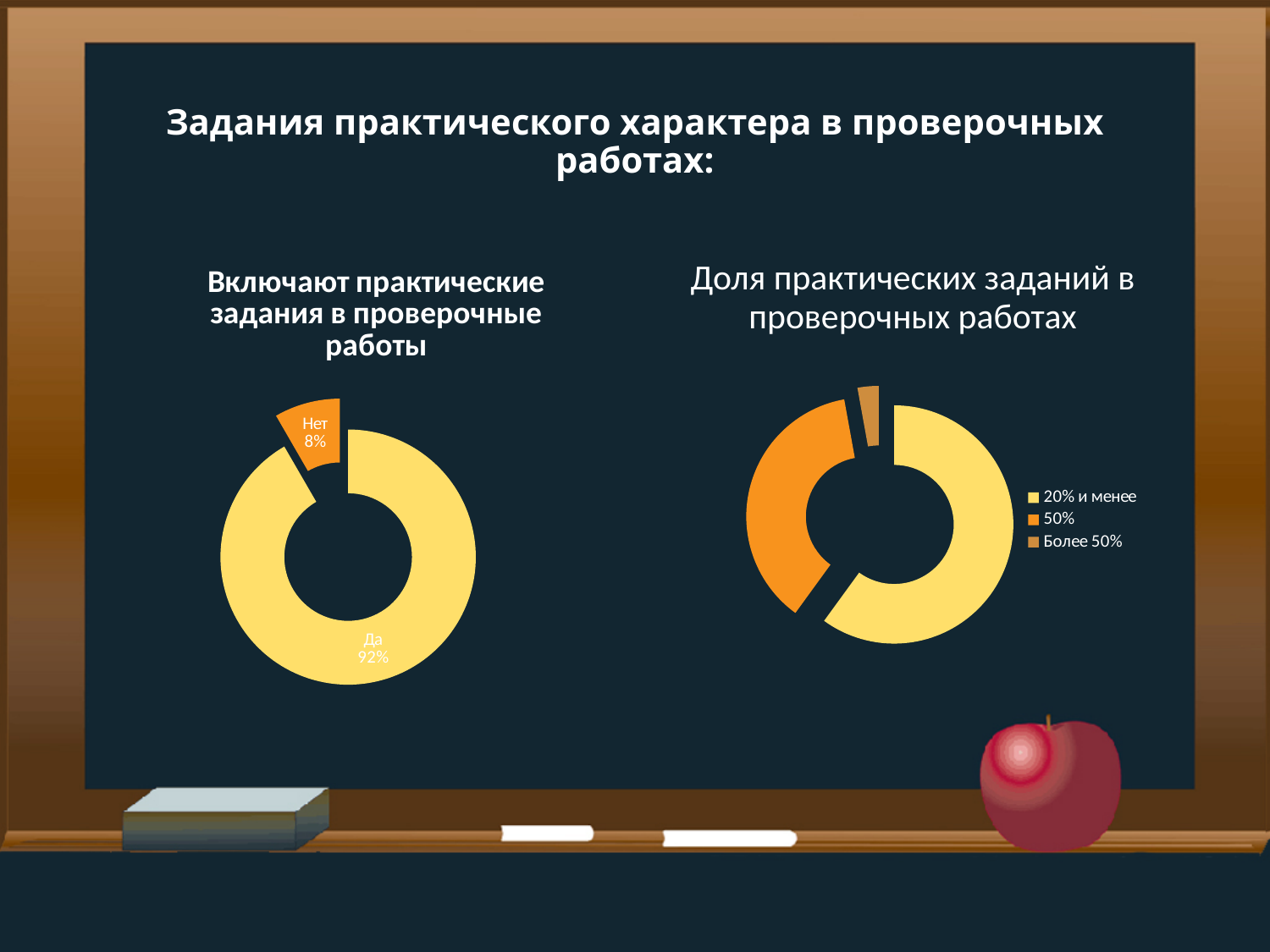
In the right chart 'Доля практических заданий в проверочных работах', how many categories does the legend list? 3 In the right chart 'Доля практических заданий в проверочных работах', which is larger: the share for '20% и менее' or for '50%'? 20% и менее What type of chart is the left chart 'Включают практические задания в проверочные работы'? Doughnut (pie) chart In the right chart 'Доля практических заданий в проверочных работах', what are the legend entries? 20% и менее, 50%, Более 50% In the right chart 'Доля практических заданий в проверочных работах', which category has the largest share? 20% и менее In the left chart 'Включают практические задания в проверочные работы', how many categories are shown? 2 In the right chart 'Доля практических заданий в проверочных работах', which category has the smallest share? Более 50% In the left chart 'Включают практические задания в проверочные работы', what is the value for 'Да'? 92% In the left chart 'Включают практические задания в проверочные работы', what is the difference between the 'Да' and 'Нет' shares? 84 percentage points In the left chart 'Включают практические задания в проверочные работы', which category has the largest share? Да In the left chart 'Включают практические задания в проверочные работы', what is the value for 'Нет'? 8% In the left chart 'Включают практические задания в проверочные работы', which category has the smallest share? Нет